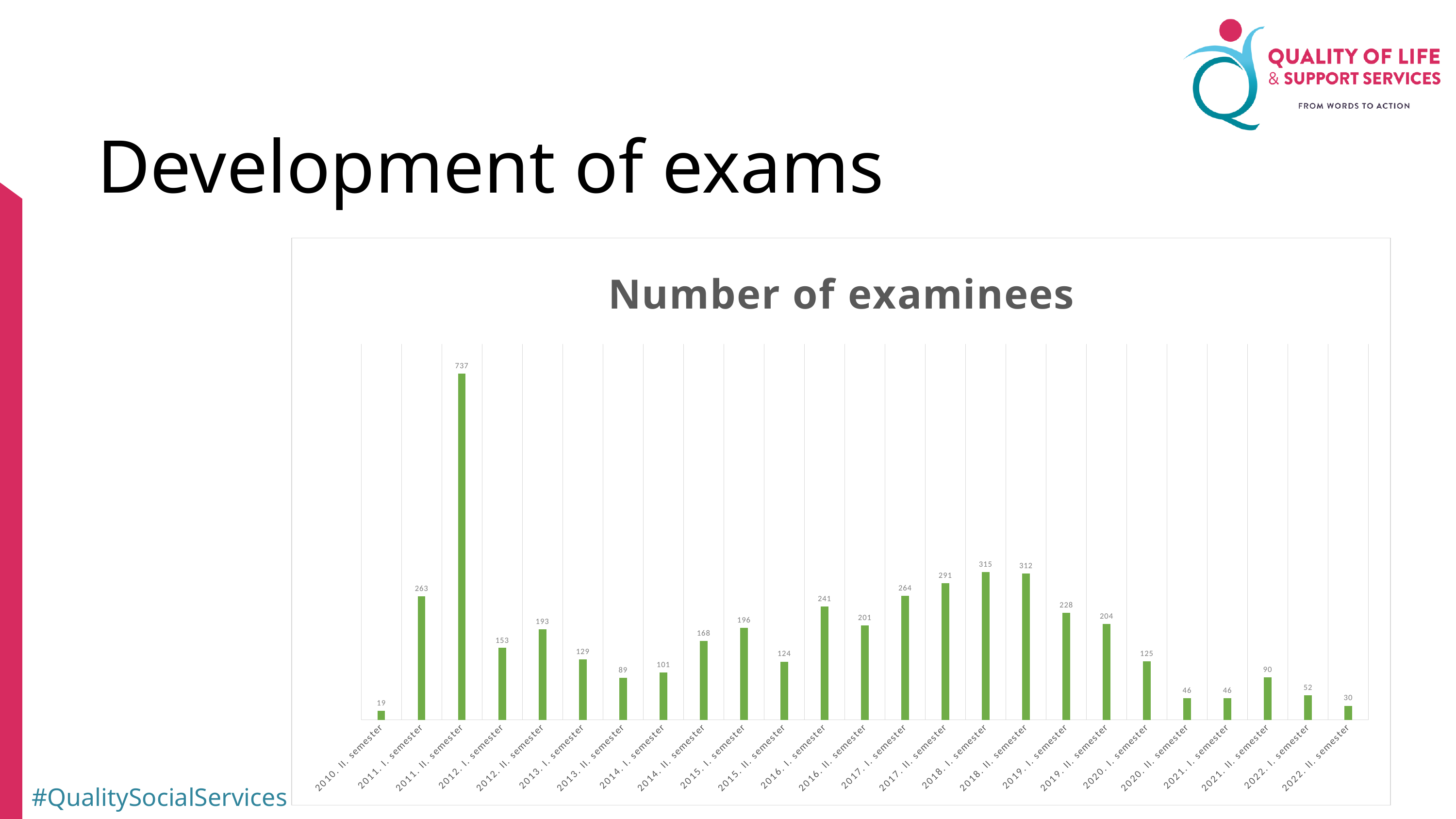
What is the difference in the number of examinees between 2011. II. semester and 2011. I. semester? 474 Which has more examinees, 2019. I. semester or 2020. I. semester? 2019. I. semester How many semesters are shown on the chart? 25 What is the difference in the number of examinees between 2017. II. semester and 2017. I. semester? 27 Which semester has the lowest number of examinees? 2010. II. semester What is the number of examinees for 2020. II. semester? 46 Which has more examinees, 2016. I. semester or 2016. II. semester? 2016. I. semester What is the number of examinees for 2011. II. semester? 737 Which semester has the highest number of examinees? 2011. II. semester What is the number of examinees for 2018. I. semester? 315 What is the title of the chart? Number of examinees What kind of chart is shown on the slide? Bar chart